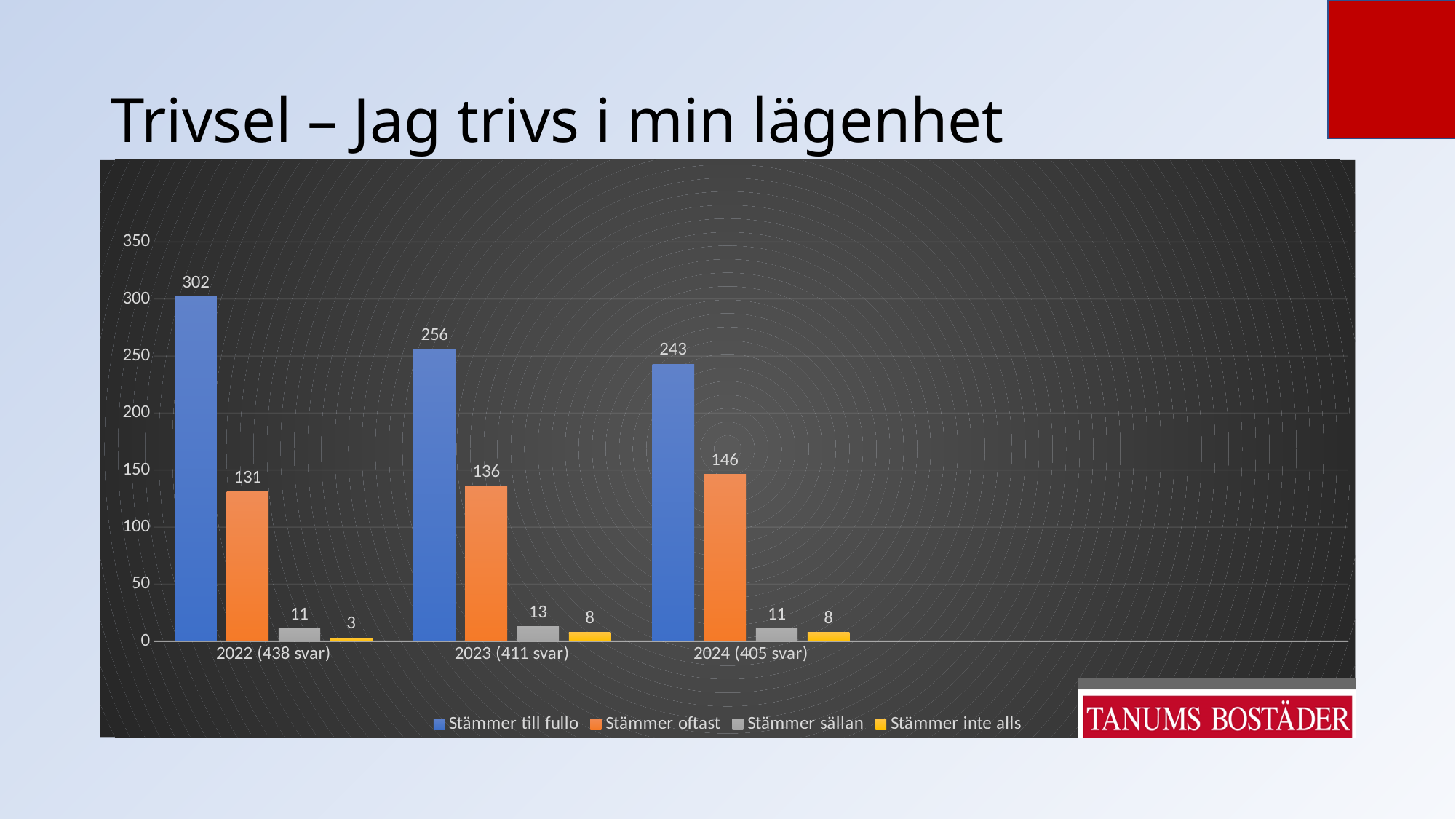
What kind of chart is shown on the slide? Bar chart Does the value for 'Stämmer till fullo' rise or fall from 2022 to 2024? Fall How many year categories are shown on the x axis? 3 Which is larger: 'Stämmer oftast' in 2023 (411 svar) or 'Stämmer oftast' in 2024 (405 svar)? 2024 (405 svar) What is the value for 'Stämmer inte alls' in 2022 (438 svar)? 3 What is the value for 'Stämmer till fullo' in 2022 (438 svar)? 302 What is the difference between 'Stämmer till fullo' in 2022 (438 svar) and in 2024 (405 svar)? 59 In which year is the value for 'Stämmer inte alls' lowest? 2022 (438 svar) What is the value for 'Stämmer oftast' in 2024 (405 svar)? 146 How many series does the legend list? 4 What is the value for 'Stämmer sällan' in 2023 (411 svar)? 13 In which year is the value for 'Stämmer till fullo' highest? 2022 (438 svar)